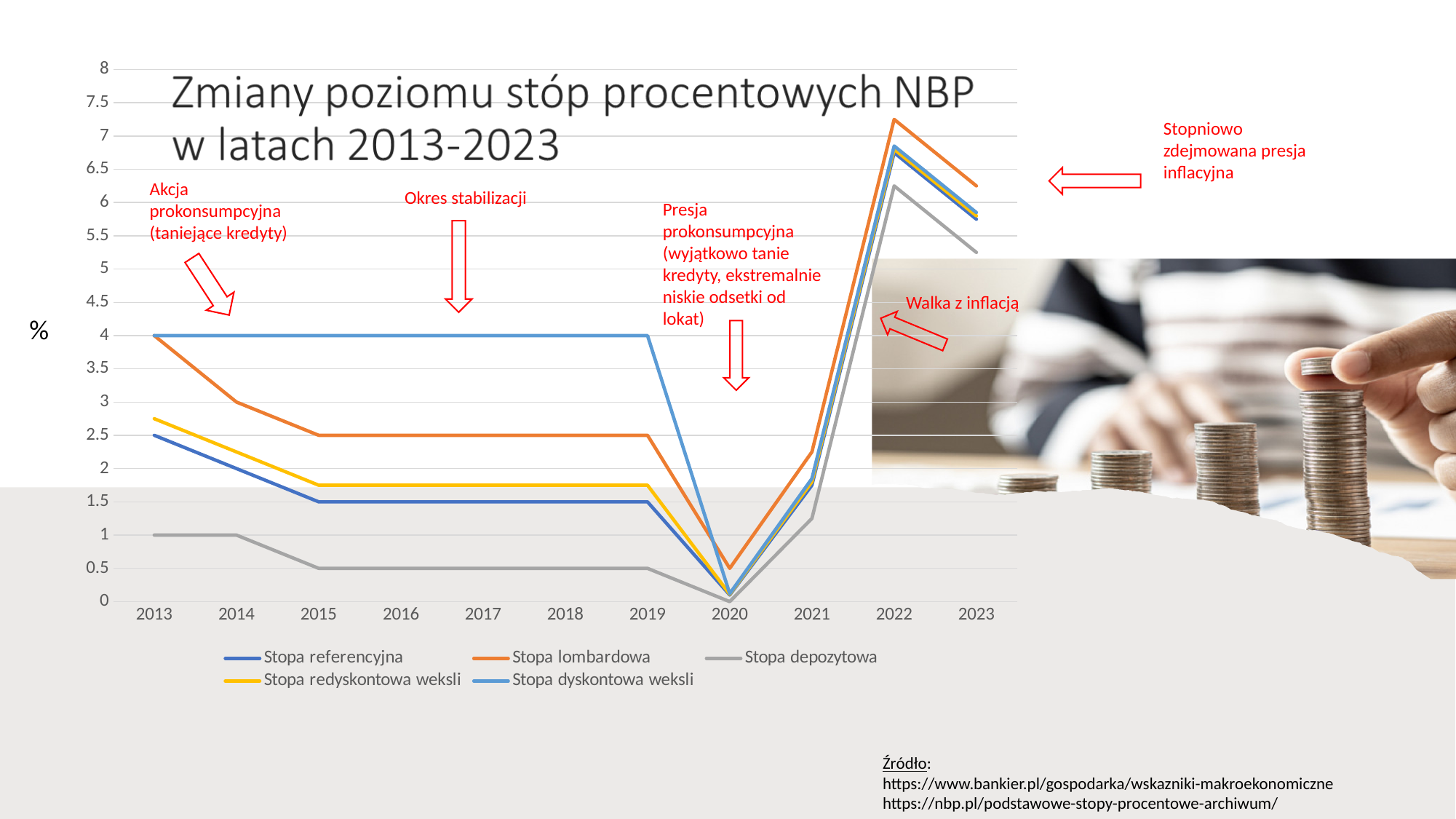
How many series does the legend list? 5 Does Stopa referencyjna rise or fall from 2013 to 2015? fall What is the value of Stopa referencyjna in 2018? 1.5 In which year is Stopa lombardowa at its highest? 2022 In 2013, which is larger: Stopa lombardowa or Stopa referencyjna? Stopa lombardowa What kind of chart is shown on the slide? line chart What is the value of Stopa lombardowa in 2017? 2.5 What is the value of Stopa depozytowa in 2013? 1 Is the value for Stopa lombardowa in 2022 greater or less than 7? greater How many years are shown on the x axis? 11 What is the value of Stopa dyskontowa weksli in 2016? 4 In which year is Stopa depozytowa at its lowest? 2020